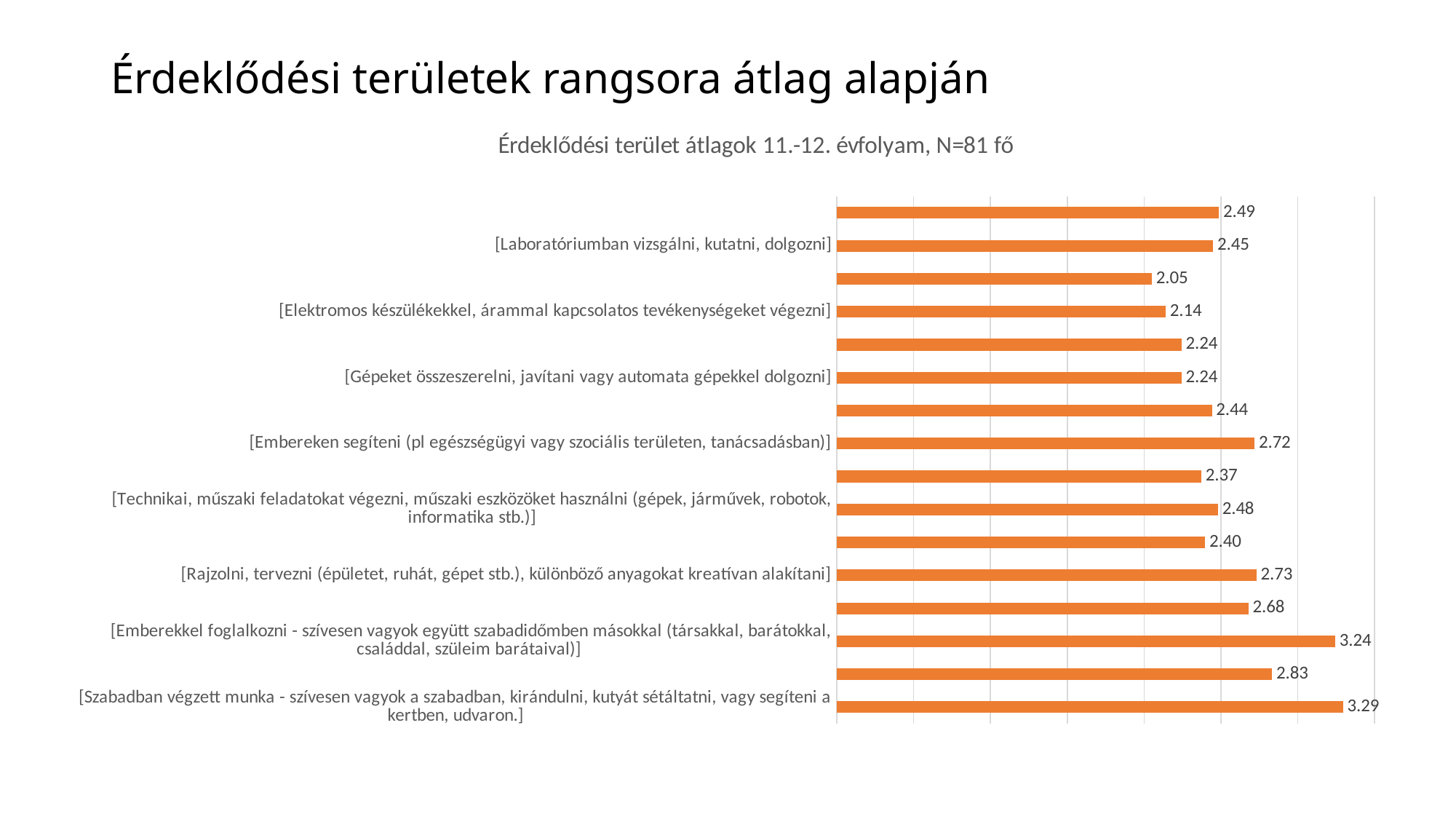
How many bars are plotted on the chart? 16 Which is larger: the value for [Rajzolni, tervezni ...] or the value for [Gépeket összeszerelni ...]? [Rajzolni, tervezni (épületet, ruhát, gépet stb.), különböző anyagokat kreatívan alakítani] Which labelled category has the highest value? [Szabadban végzett munka - szívesen vagyok a szabadban, kirándulni, kutyát sétáltatni, vagy segíteni a kertben, udvaron.] What is the lowest value shown on the chart? 2.05 What is the value for [Laboratóriumban vizsgálni, kutatni, dolgozni]? 2.45 What is the difference between the values for [Szabadban végzett munka ...] and [Emberekkel foglalkozni ...]? 0.05 What type of chart is shown on the slide? bar chart What is the difference between the values for [Embereken segíteni ...] and [Elektromos készülékekkel ...]? 0.58 What is the value for [Elektromos készülékekkel, árammal kapcsolatos tevékenységeket végezni]? 2.14 What is the value for [Embereken segíteni (pl egészségügyi vagy szociális területen, tanácsadásban)]? 2.72 What is the title of the chart? Érdeklődési terület átlagok 11.-12. évfolyam, N=81 fő What is the value for [Szabadban végzett munka - szívesen vagyok a szabadban, kirándulni, kutyát sétáltatni, vagy segíteni a kertben, udvaron.]? 3.29